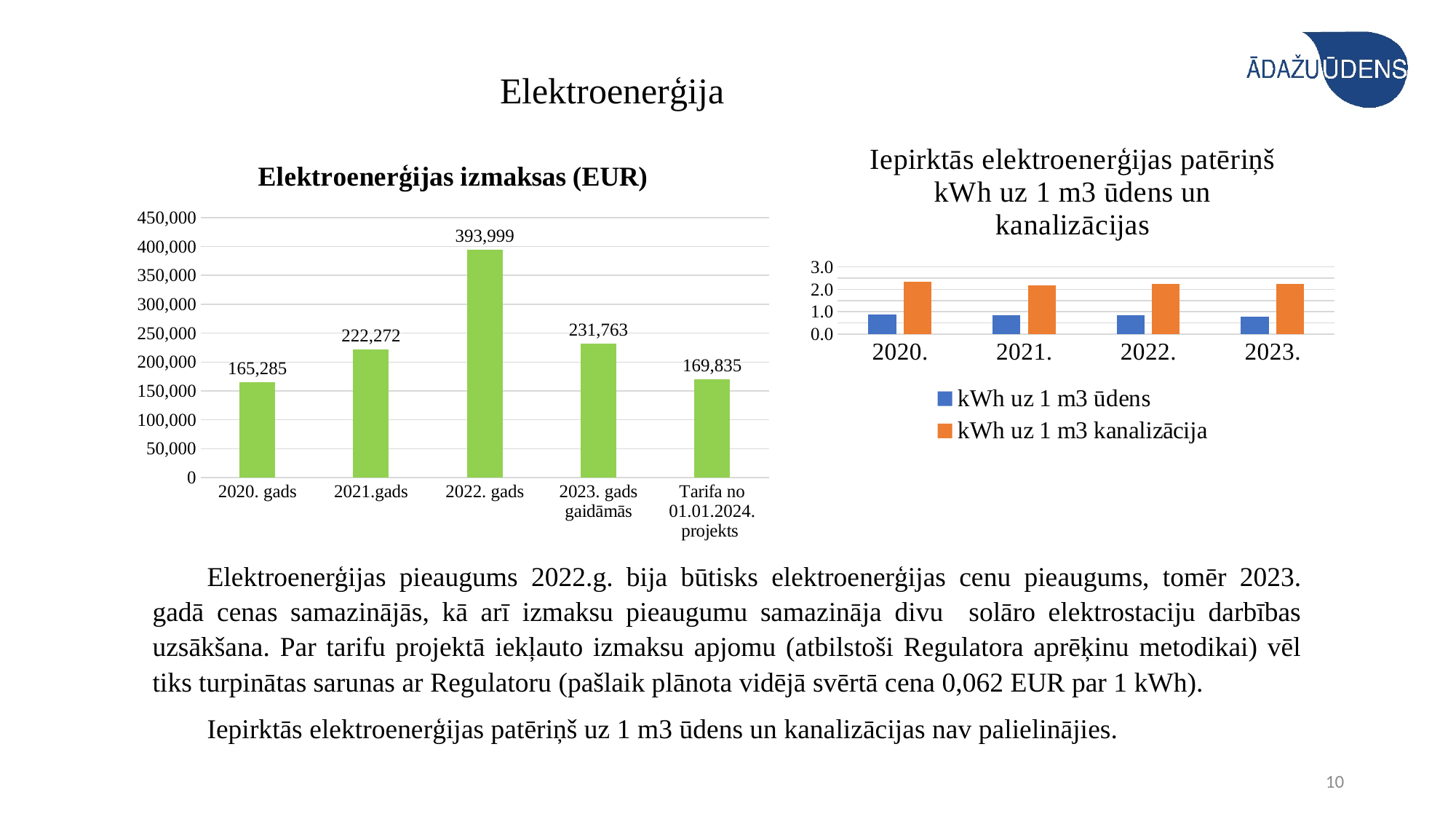
In the chart 'Elektroenerģijas izmaksas (EUR)', what is the value for 'Tarifa no 01.01.2024. projekts'? 169,835 In the chart 'Elektroenerģijas izmaksas (EUR)', what is the difference between the values for 2022. gads and 2021.gads? 171,727 In the chart 'Iepirktās elektroenerģijas patēriņš kWh uz 1 m3 ūdens un kanalizācijas', is the value for 'kWh uz 1 m3 ūdens' in 2023. greater or less than 1.0? less In the chart 'Iepirktās elektroenerģijas patēriņš kWh uz 1 m3 ūdens un kanalizācijas', is the value for 'kWh uz 1 m3 kanalizācija' in 2020. greater or less than 2.0? greater How many categories are shown in the chart 'Elektroenerģijas izmaksas (EUR)'? 5 In the chart 'Elektroenerģijas izmaksas (EUR)', which category has the highest value? 2022. gads In the chart 'Elektroenerģijas izmaksas (EUR)', what is the value for 2022. gads? 393,999 In the chart 'Elektroenerģijas izmaksas (EUR)', which is larger: the value for 2023. gads gaidāmās or the value for 2021.gads? 2023. gads gaidāmās What type of chart is the chart on the right of the slide, 'Iepirktās elektroenerģijas patēriņš kWh uz 1 m3 ūdens un kanalizācijas'? Bar chart In the chart 'Elektroenerģijas izmaksas (EUR)', what is the value for 2020. gads? 165,285 In the chart 'Elektroenerģijas izmaksas (EUR)', which category has the lowest value? 2020. gads How many series does the legend list in the chart 'Iepirktās elektroenerģijas patēriņš kWh uz 1 m3 ūdens un kanalizācijas'? 2